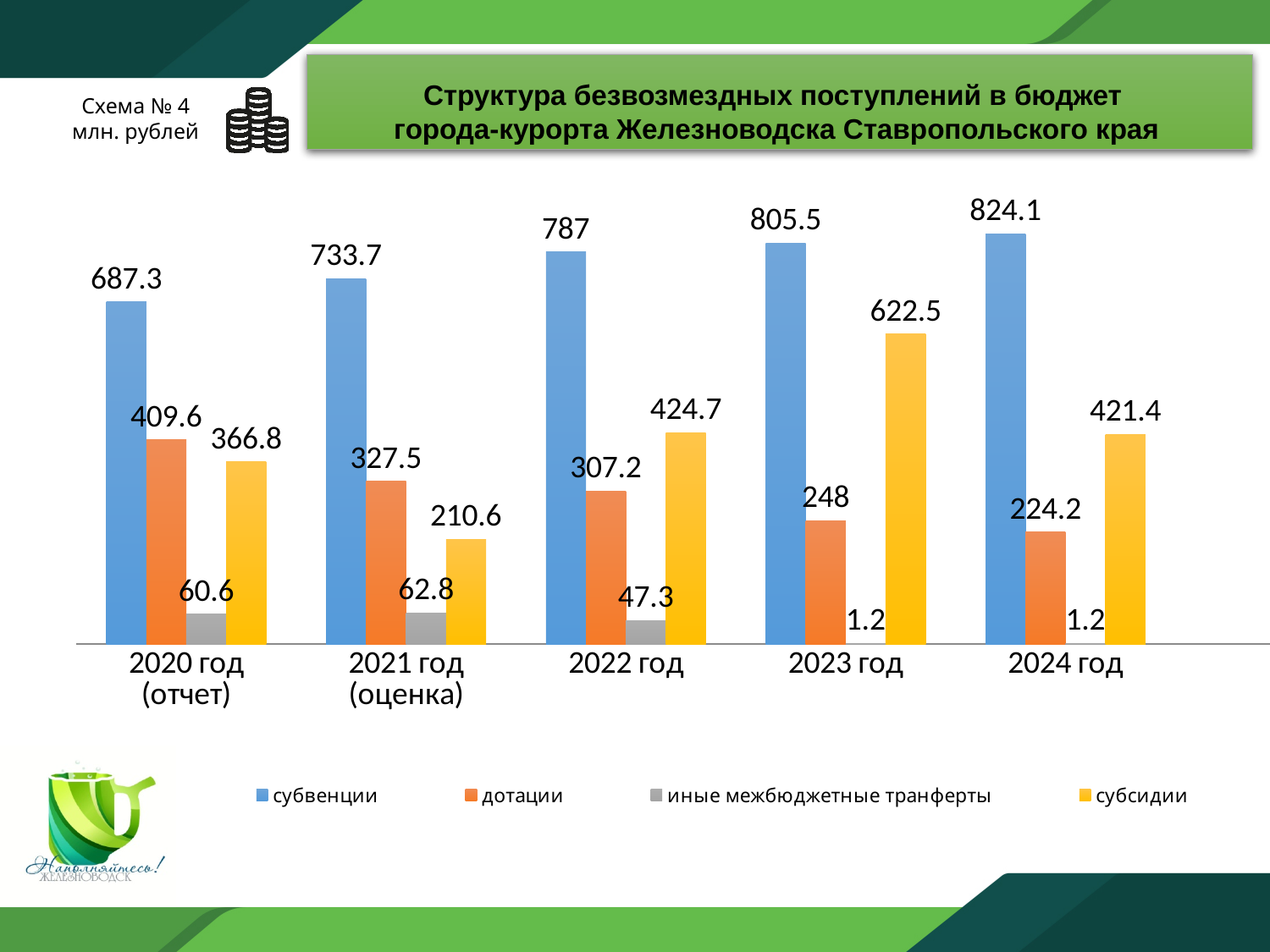
What is the value of дотации for 2020 год (отчет)? 409.6 Which is larger in 2023 год: дотации or субсидии? субсидии In which year is the value of субвенции the highest? 2024 год What is the difference between субвенции in 2024 год and субвенции in 2020 год (отчет)? 136.8 How many year categories are shown on the x axis? 5 What is the value of субсидии for 2023 год? 622.5 What is the value of субвенции for 2022 год? 787 What is the value of иные межбюджетные транферты for 2021 год (оценка)? 62.8 In which year is the value of субсидии the lowest? 2021 год (оценка) How many series does the legend list? 4 What kind of chart is shown on the slide? bar chart Do the values of субвенции rise or fall from 2020 год (отчет) to 2024 год? rise